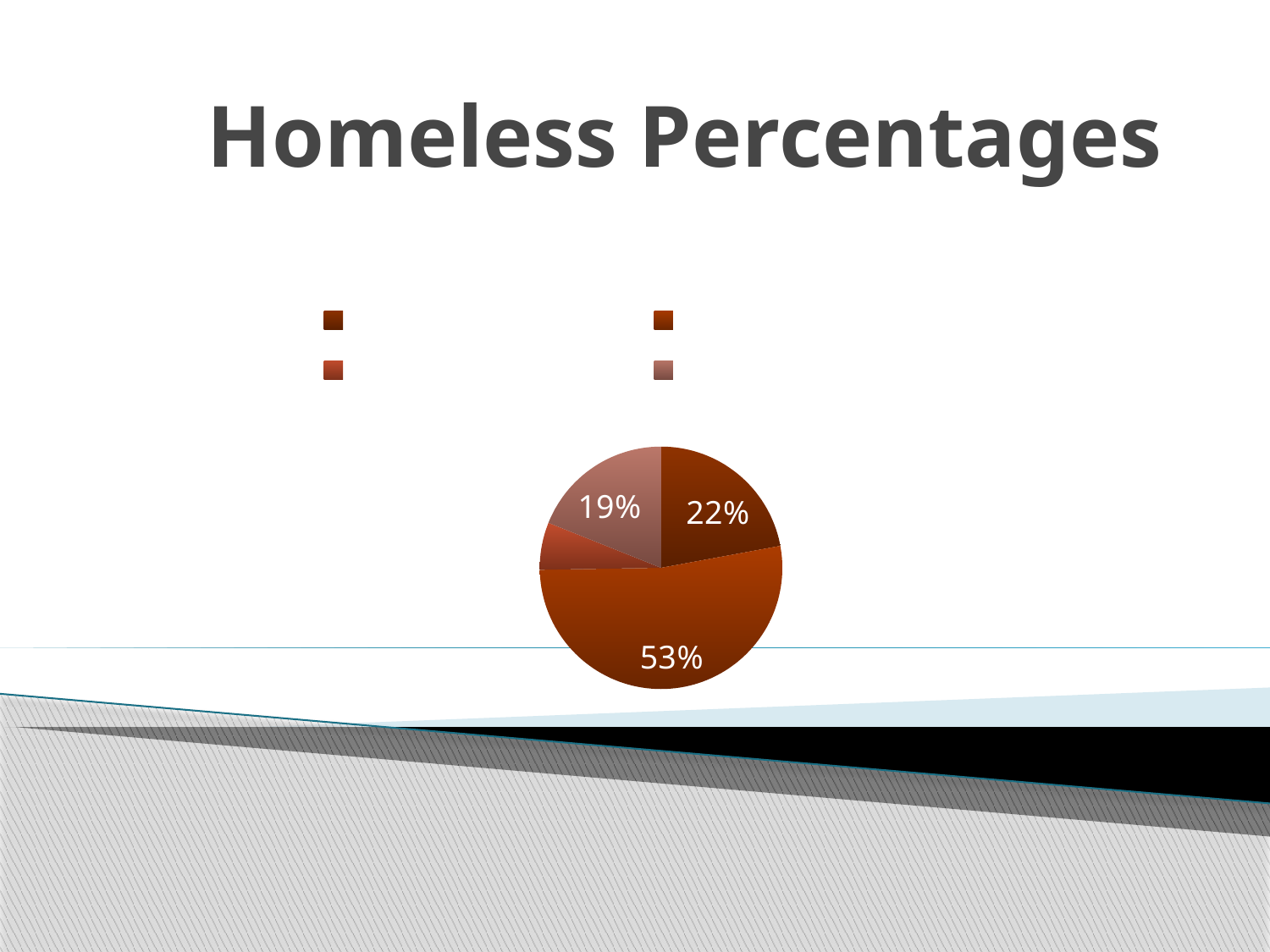
What is the value of the largest slice of the pie chart? 53% How many entries does the legend of the pie chart show? 4 Is the largest slice of the pie chart greater or less than 50%? greater What share of the pie does the darkest slice at the top right represent? 22% How many slices does the pie chart have? 4 What do the three labelled slices (22%, 53%, 19%) add up to? 94% What is the difference between the largest slice (53%) and the slice labelled 22%? 31 percentage points What kind of chart is shown on the slide? pie chart What is the difference between the slices labelled 22% and 19%? 3 percentage points Which is larger, the slice labelled 22% or the slice labelled 19%? 22% What is the title of the chart on the slide? Homeless Percentages Of the labelled slices, which has the smallest value? 19%